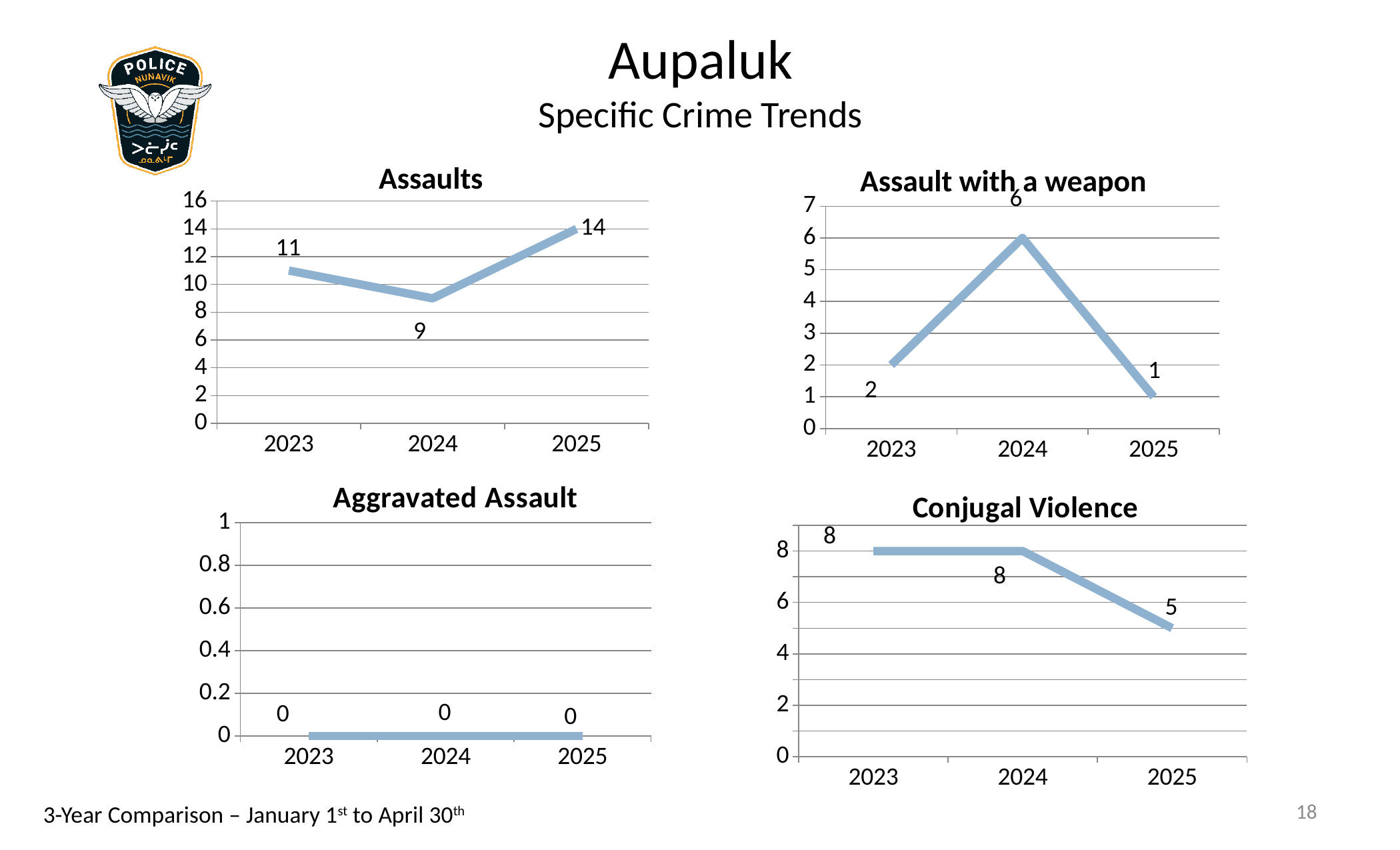
What kind of chart is the Assault with a weapon chart? line chart In the Assault with a weapon chart, what is the difference between the 2024 and 2023 values? 4 In the Conjugal Violence chart, what is the value for 2025? 5 How many years are plotted in the Assaults chart? 3 In the Assault with a weapon chart, what is the value for 2024? 6 In the Assaults chart, what is the difference between the 2025 and 2023 values? 3 In the Assaults chart, which year has the highest value? 2025 In the Assault with a weapon chart, which year has the lowest value? 2025 In the Aggravated Assault chart, what is the value for 2025? 0 In the Conjugal Violence chart, do the values rise or fall from 2024 to 2025? fall In the Assaults chart, what is the value for 2024? 9 In the Conjugal Violence chart, is the value for 2023 larger or smaller than the value for 2025? larger